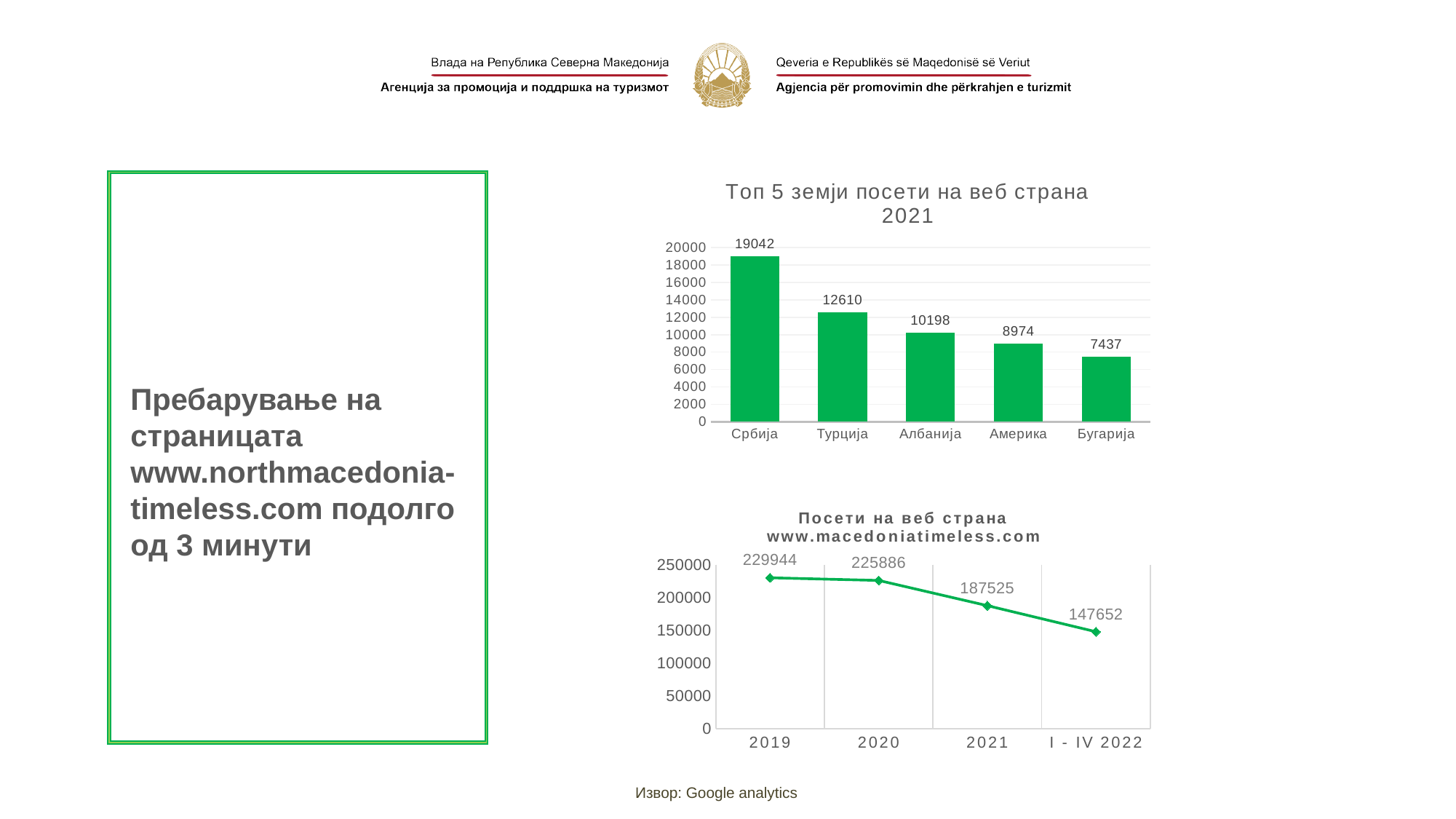
What type of chart is 'Топ 5 земји посети на веб страна 2021'? Bar chart In the chart 'Топ 5 земји посети на веб страна 2021', how many countries are shown? 5 In the chart 'Посети на веб страна www.macedoniatimeless.com', what is the difference between the values for 2020 and 2021? 38361 In the chart 'Топ 5 земји посети на веб страна 2021', what is the value for Србија? 19042 In the chart 'Топ 5 земји посети на веб страна 2021', what is the difference between the values for Србија and Турција? 6432 In the chart 'Топ 5 земји посети на веб страна 2021', which country has the lowest value? Бугарија In the chart 'Посети на веб страна www.macedoniatimeless.com', what is the value for I - IV 2022? 147652 In the chart 'Посети на веб страна www.macedoniatimeless.com', what is the value for 2019? 229944 In the chart 'Топ 5 земји посети на веб страна 2021', which country has the highest value? Србија In the chart 'Топ 5 земји посети на веб страна 2021', what is the value for Бугарија? 7437 In the chart 'Посети на веб страна www.macedoniatimeless.com', do the values rise or fall from 2019 to I - IV 2022? Fall What type of chart is 'Посети на веб страна www.macedoniatimeless.com'? Line chart